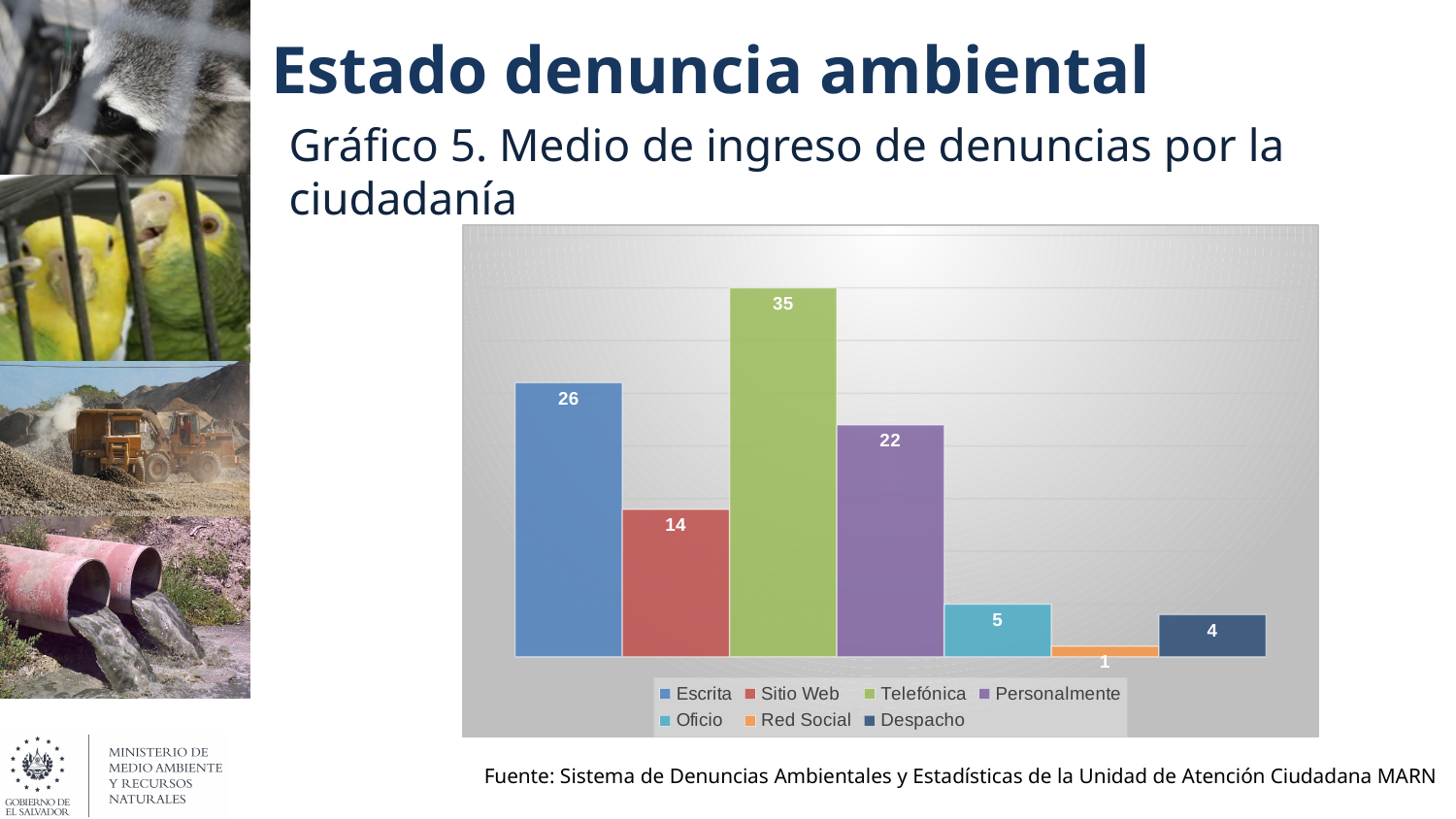
What is the difference between the values for Telefónica and Escrita? 9 Which is larger, the value for Escrita or the value for Personalmente? Escrita What colour is the bar for Telefónica? Green What is the value for Telefónica? 35 What is the value for Despacho? 4 How many categories are shown in the chart? 7 Which category has the lowest value? Red Social What kind of chart is shown on the slide? Bar chart Which is larger, the value for Oficio or the value for Despacho? Oficio What is the value for Sitio Web? 14 Which category has the highest value? Telefónica What is the difference between the values for Personalmente and Oficio? 17